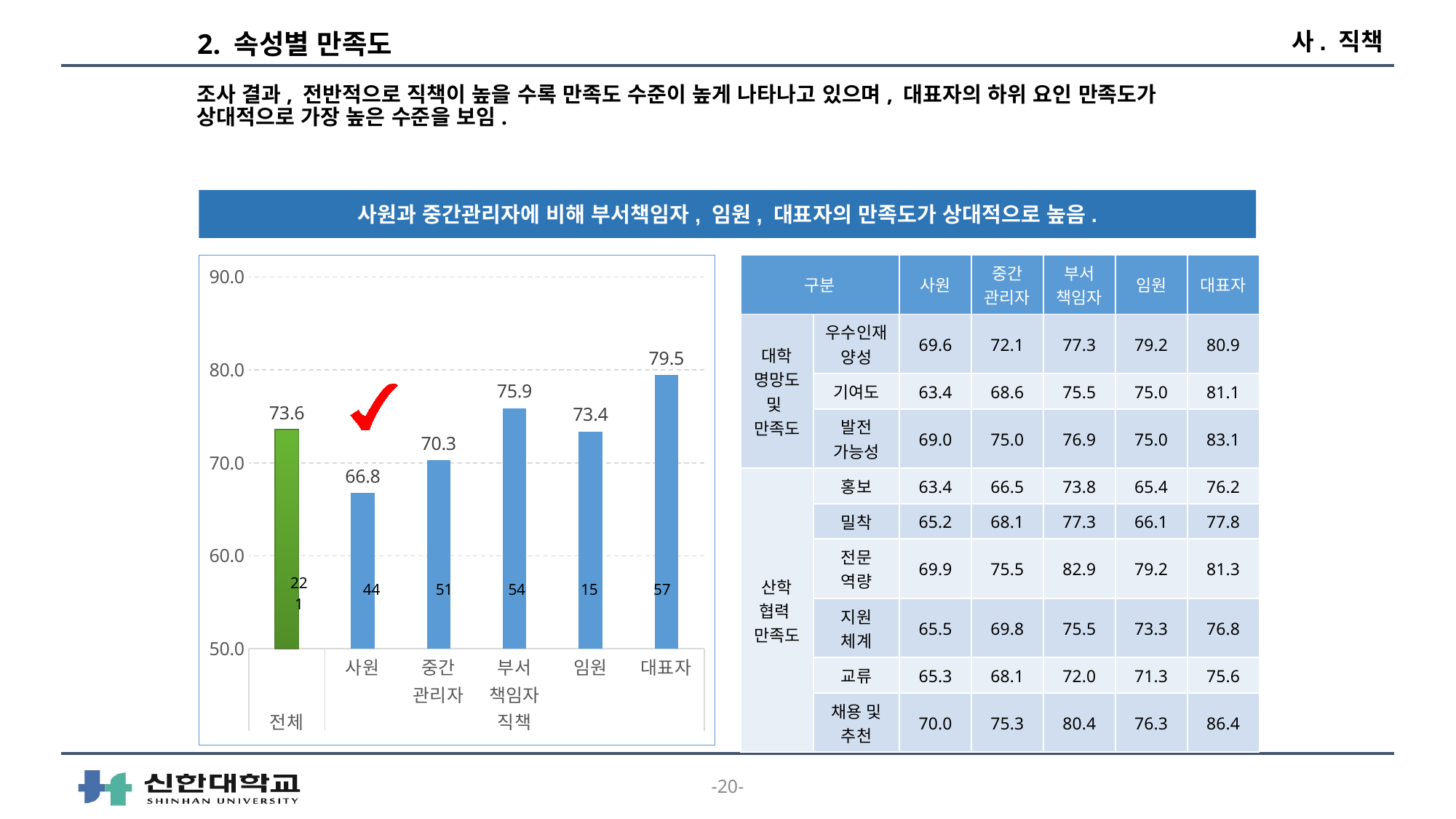
What is the value of the 전체 bar in the chart? 73.6 Is the value for 중간관리자 greater or less than 80.0? less Which is larger in the chart, the value for 부서책임자 or the value for 임원? 부서책임자 What is the satisfaction value shown for 대표자 in the bar chart? 79.5 How many bars are plotted in the chart? 6 Which category has the lowest bar in the chart? 사원 What value is shown for 사원 in the bar chart? 66.8 What is the difference between the values for 대표자 and 사원 in the chart? 12.7 What kind of chart is shown on the left of the slide? bar chart What is the difference between the values for 부서책임자 and 중간관리자 in the chart? 5.6 Which category has the highest bar in the chart? 대표자 What colour is the 전체 bar in the chart? green